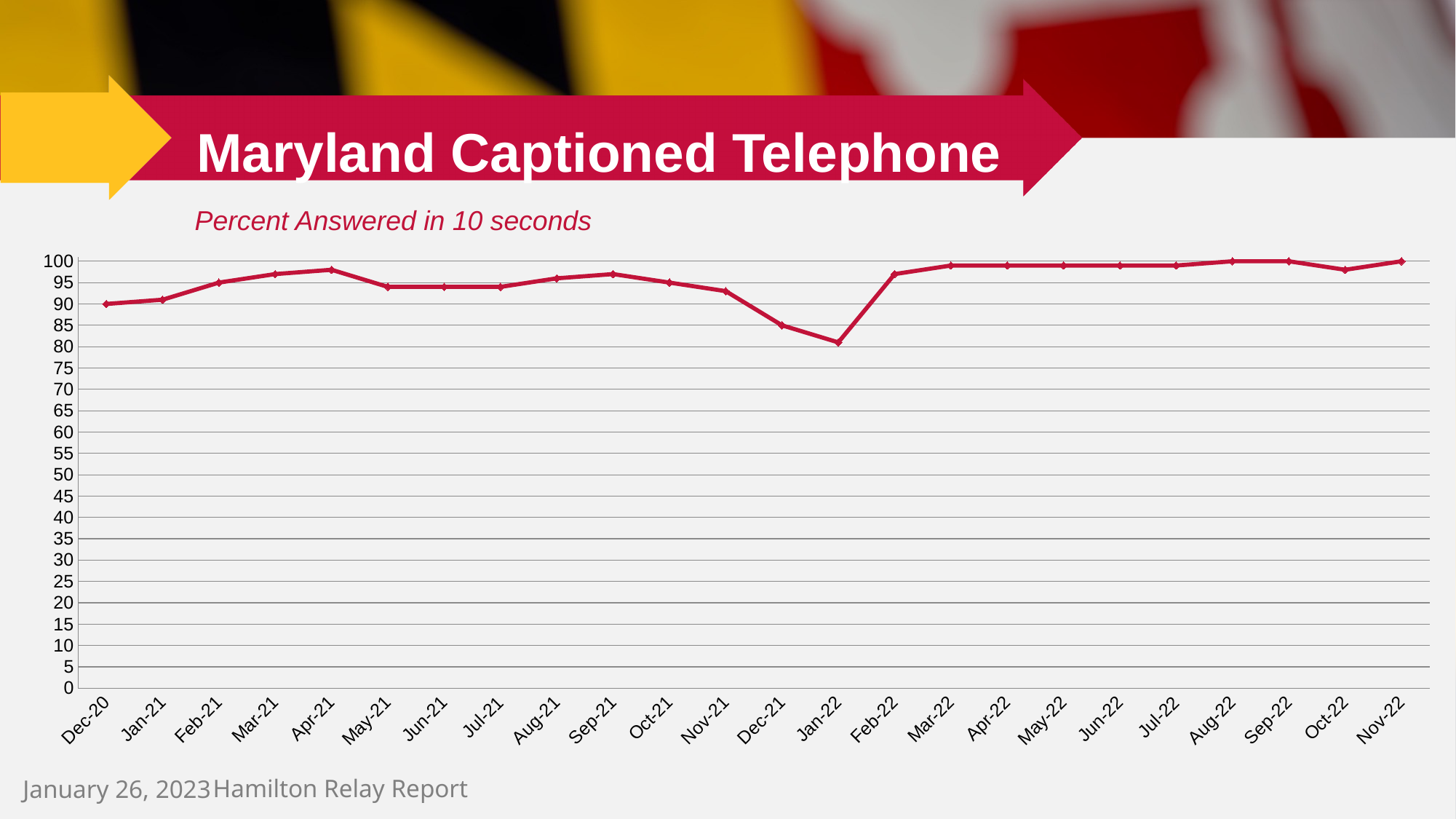
Is the value for Jan-22 greater or less than 85? less Does the value rise or fall from Dec-21 to Jan-22? fall What is the subtitle of the chart? Percent Answered in 10 seconds Which month has the lowest percent answered in 10 seconds? Jan-22 Is the value for Nov-21 greater or less than 90? greater How many months are plotted along the x axis? 24 What kind of chart is shown on the slide? line chart Is the value for Apr-21 greater or less than 95? greater Which is higher, the value for Apr-21 or the value for May-21? Apr-21 Which is higher, the value for Dec-21 or the value for Feb-22? Feb-22